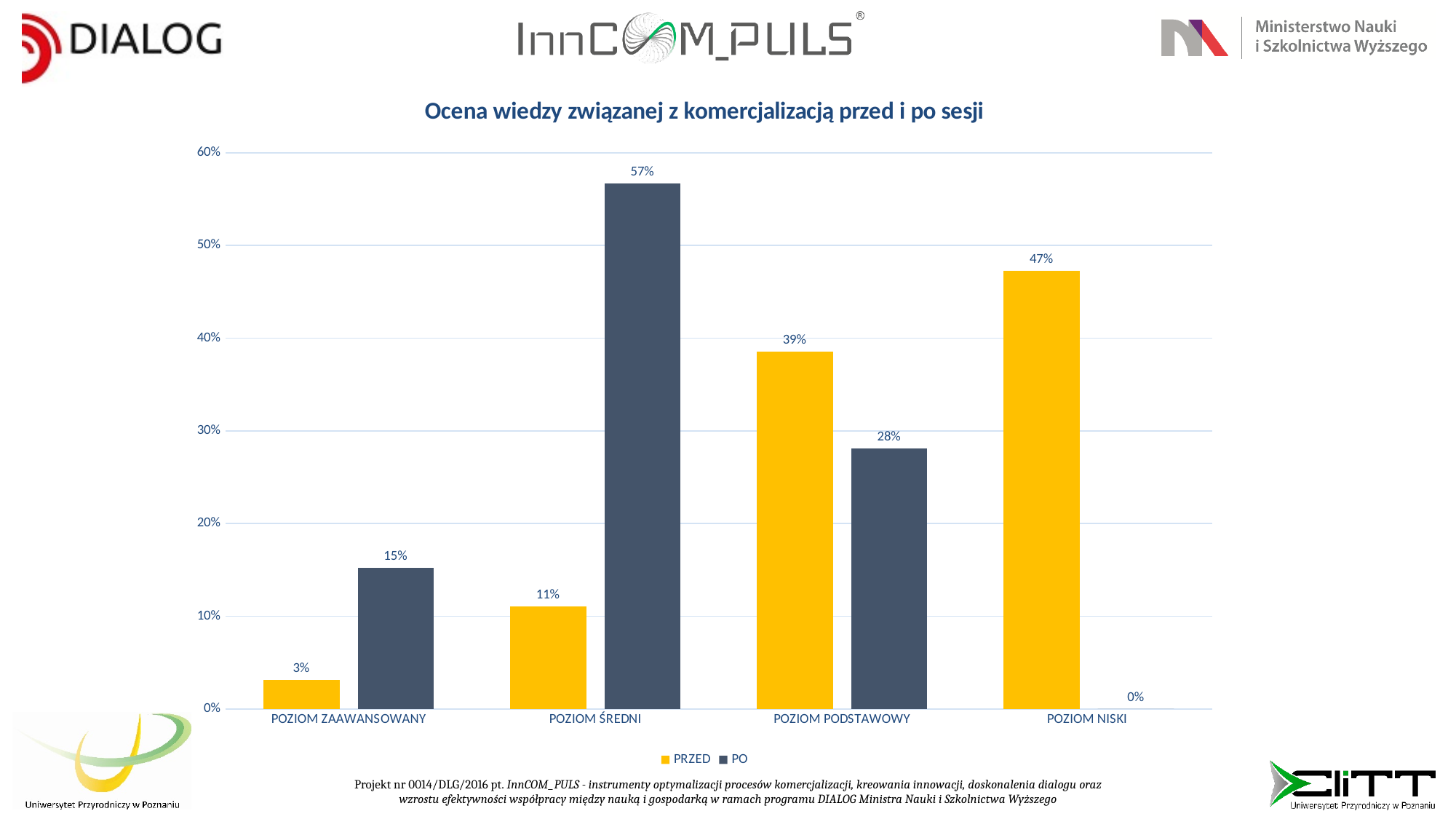
How many categories are shown on the x axis? 4 What is the title of the chart? Ocena wiedzy związanej z komercjalizacją przed i po sesji Which is larger for POZIOM PODSTAWOWY, the PRZED value or the PO value? PRZED What is the PRZED value for POZIOM NISKI? 47% What is the PRZED value for POZIOM ZAAWANSOWANY? 3% How many series does the legend list? 2 What kind of chart is shown on the slide? Bar chart What is the PO value for POZIOM PODSTAWOWY? 28% What is the PO value for POZIOM ŚREDNI? 57% What is the difference between the PO and PRZED values for POZIOM ŚREDNI? 46% Which category has the highest PO value? POZIOM ŚREDNI Which category has the lowest PRZED value? POZIOM ZAAWANSOWANY